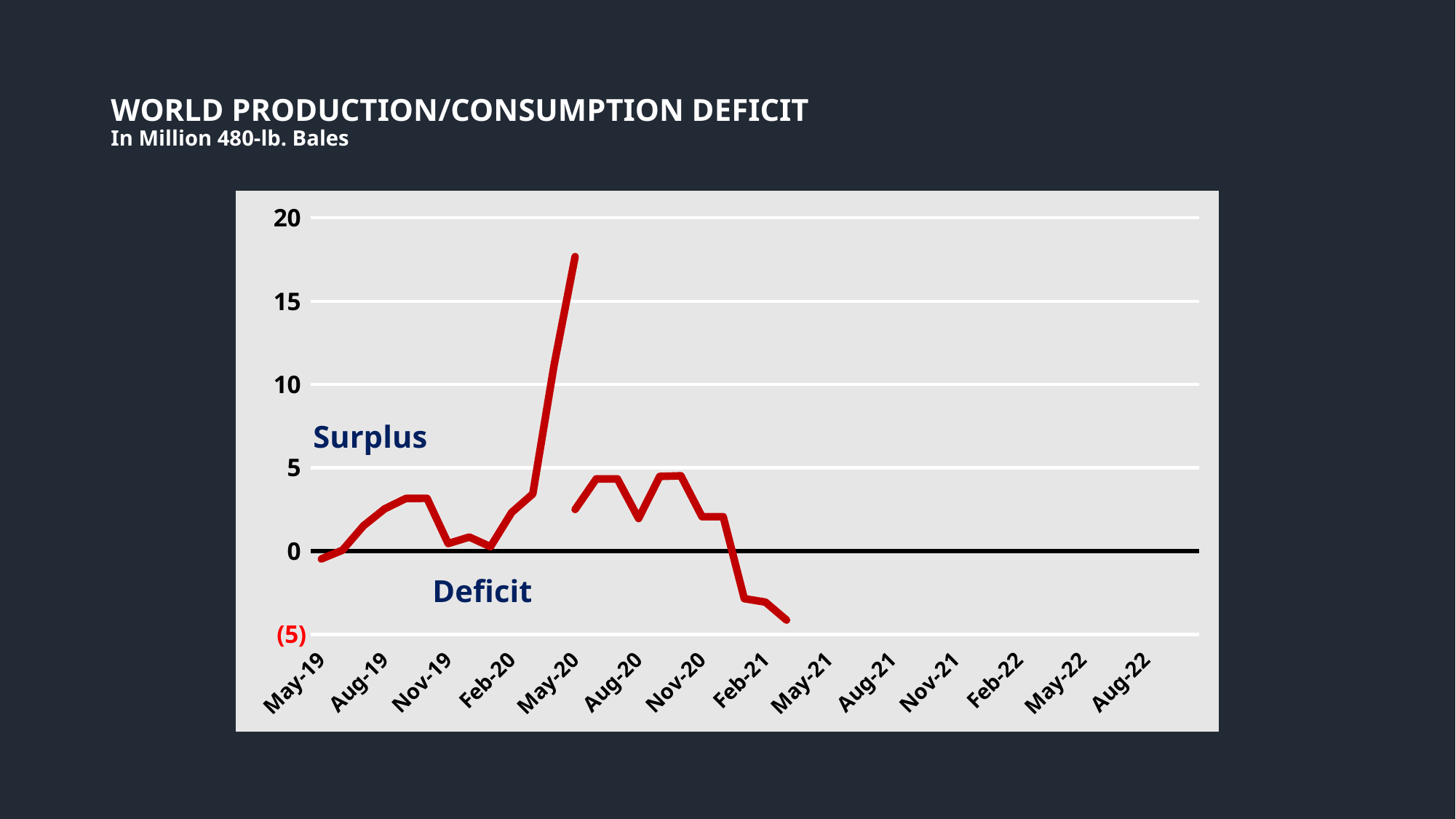
In what units are the values on the chart expressed? Million 480-lb. Bales What kind of chart is shown on the slide? line chart Does the line rise or fall between Feb-20 and May-20? rise How many month labels are shown on the x axis? 14 Is the value for Nov-20 greater or less than 0? greater Does the line rise or fall between Nov-20 and Feb-21? fall Which is larger, the value for Nov-20 or the value for Feb-21? Nov-20 Is the value for Feb-21 greater or less than 0? less What is the title of the chart? WORLD PRODUCTION/CONSUMPTION DEFICIT Is the value for Aug-19 greater or less than 5? less Which labeled month has the highest value on the chart? May-20